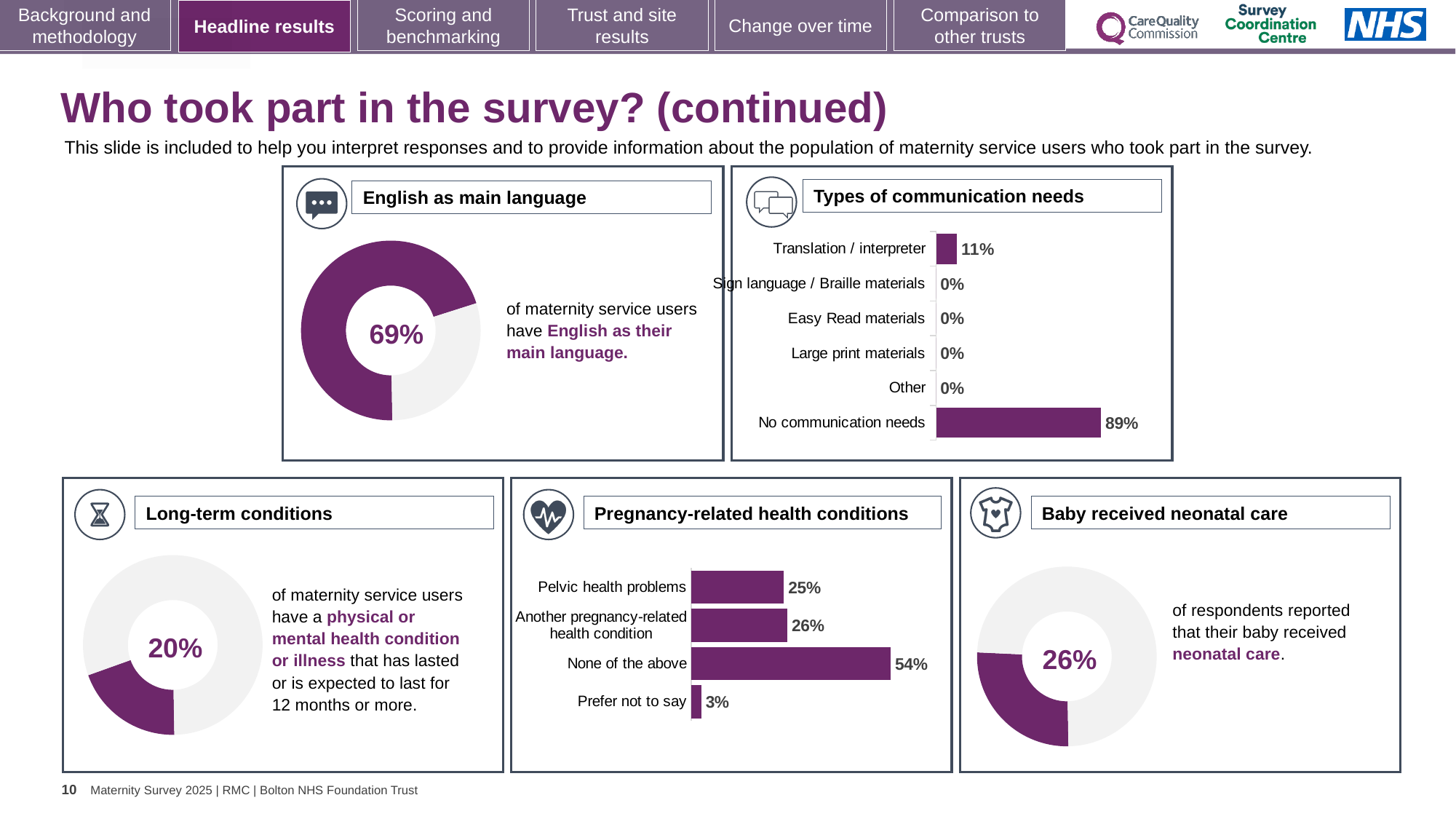
In the 'Pregnancy-related health conditions' chart, what is the difference between None of the above and Pelvic health problems? 29% What kind of chart is the 'Pregnancy-related health conditions' chart? Bar chart In the 'Pregnancy-related health conditions' chart, which category has the lowest value? Prefer not to say In the 'Long-term conditions' chart, what percentage of maternity service users have a physical or mental health condition or illness? 20% In the 'Baby received neonatal care' chart, what percentage of respondents reported that their baby received neonatal care? 26% In the 'Types of communication needs' chart, which category has the highest value? No communication needs In the 'Types of communication needs' chart, how many categories are shown? 6 In the 'English as main language' chart, what percentage of maternity service users have English as their main language? 69% In the 'Types of communication needs' chart, what is the value for Translation / interpreter? 11% In the 'Pregnancy-related health conditions' chart, what is the value for None of the above? 54% In the 'Pregnancy-related health conditions' chart, which is larger: Pelvic health problems or Another pregnancy-related health condition? Another pregnancy-related health condition In the 'Types of communication needs' chart, what is the difference between No communication needs and Translation / interpreter? 78%